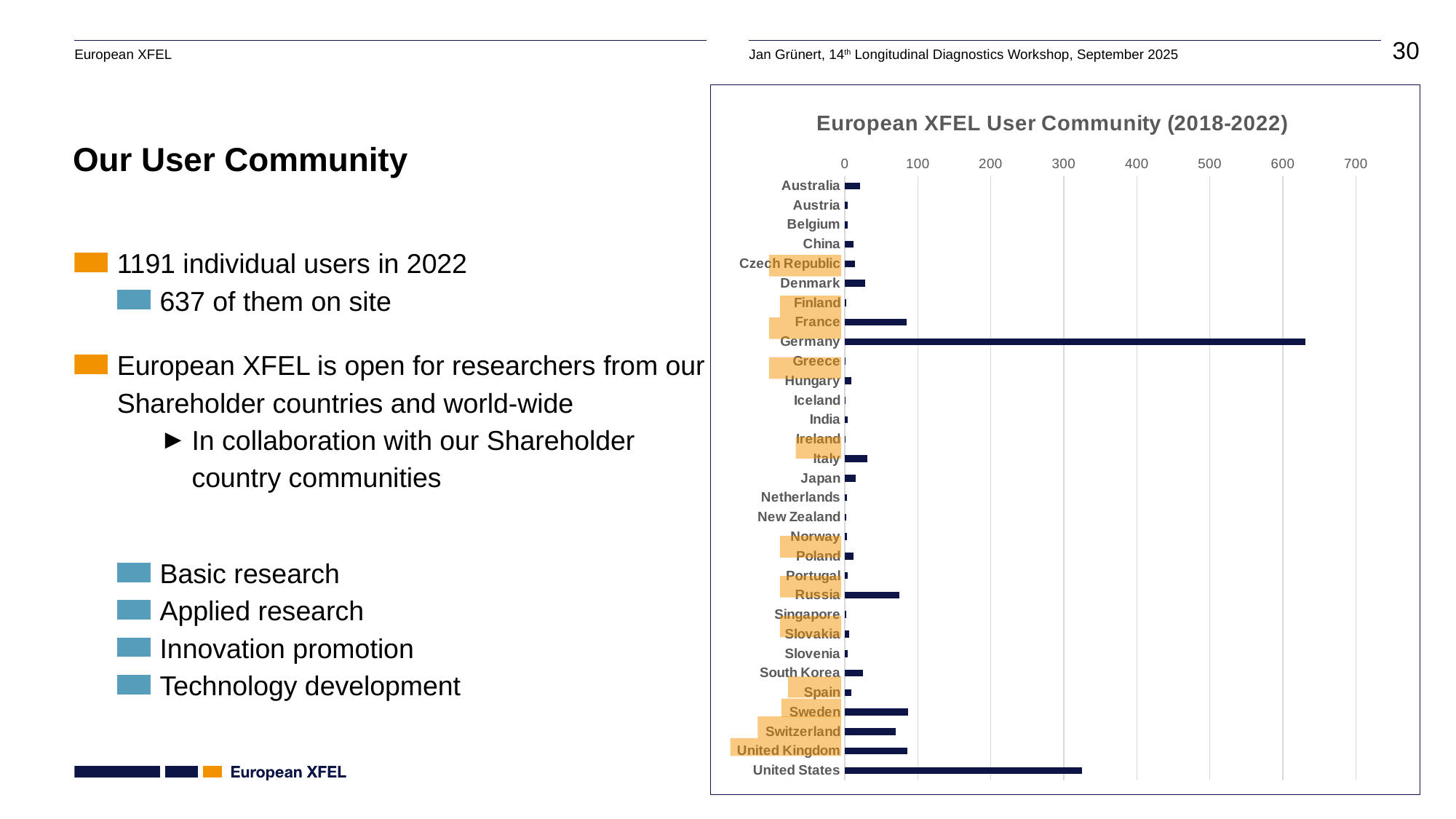
What is the title of the chart? European XFEL User Community (2018-2022) Is the value for United States greater or less than 400? less Is the value for United States greater or less than 300? greater Is the value for Russia greater or less than 100? less Which has a larger value, Sweden or Denmark? Sweden How many countries are listed in the chart? 31 Which has a larger value, United States or Russia? United States What kind of chart is shown on the slide? bar chart Which has a larger value, Germany or United States? Germany Which country has the highest value in the chart? Germany